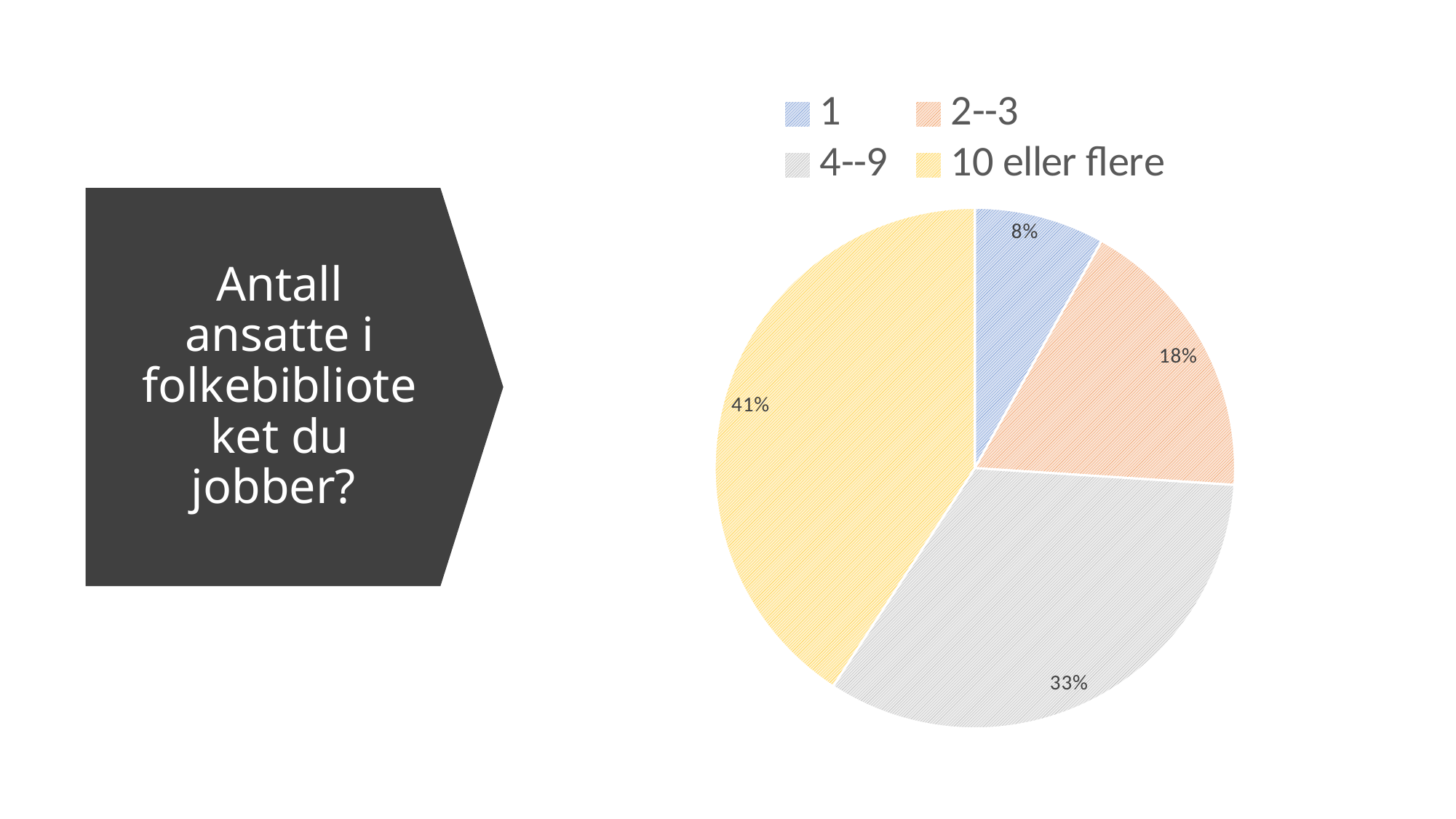
How many categories does the pie chart have? 4 Which category has the largest slice of the pie? 10 eller flere What share of the pie does the "10 eller flere" category have? 41% What is the question shown in the text box next to the chart? Antall ansatte i folkebiblioteket du jobber? What share of the pie does the "1" category have? 8% Which slice is larger, "2--3" or "4--9"? 4--9 Which category has the smallest slice of the pie? 1 What share of the pie does the "2--3" category have? 18% What is the difference in percentage points between the "10 eller flere" slice and the "4--9" slice? 8 What share of the pie does the "4--9" category have? 33% What is the combined share of the "1" and "2--3" slices? 26% What kind of chart is shown on the slide? pie chart